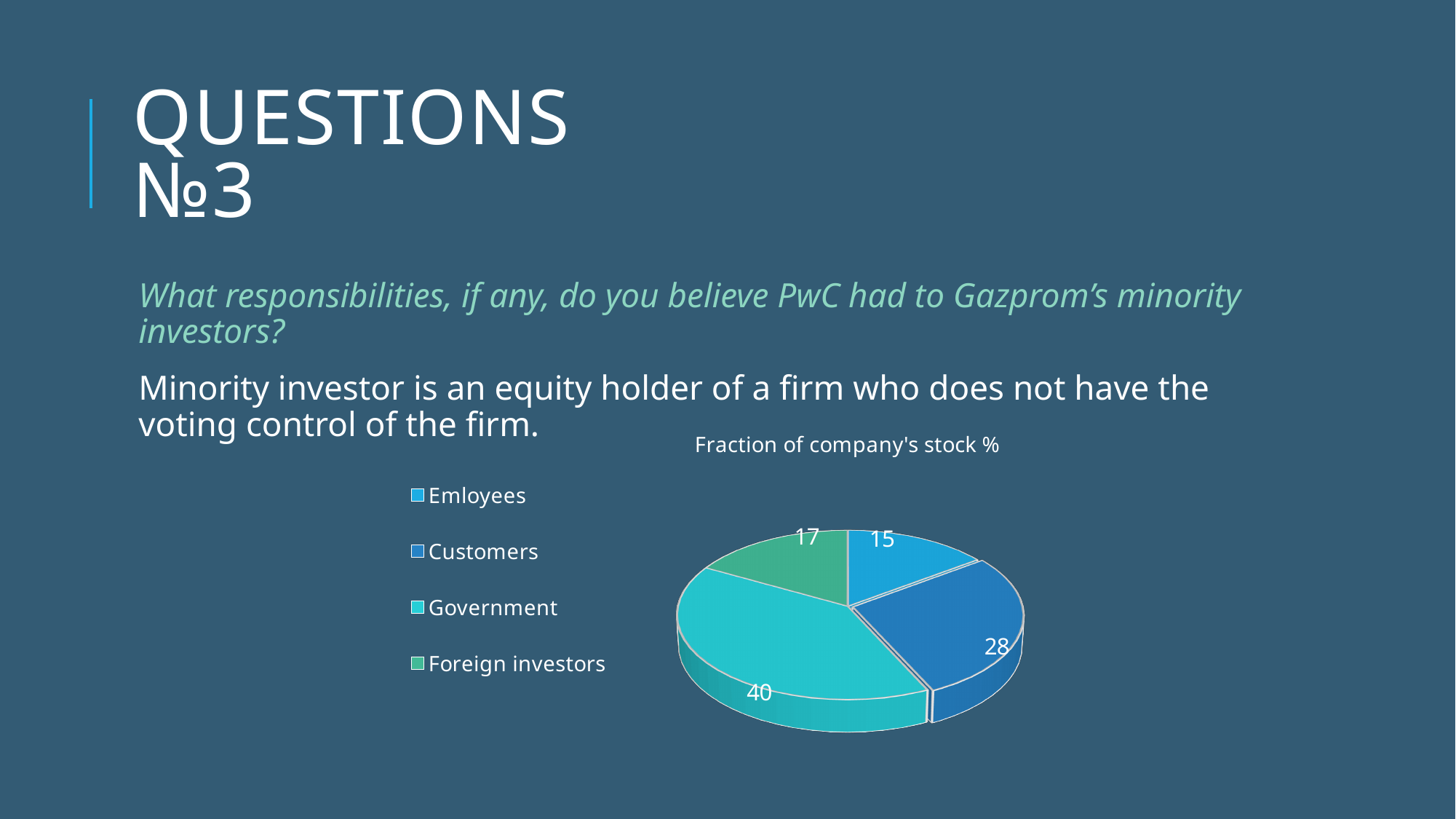
What is the value for Foreign investors in the pie chart? 17 What is the value for Emloyees in the pie chart? 15 How many slices does the pie chart have? 4 Which category has the largest slice of the pie chart? Government What is the difference between the Government and Customers values in the pie chart? 12 Which is larger in the pie chart, Foreign investors or Emloyees? Foreign investors What is the total of all the slice values in the pie chart? 100 What is the title of the chart? Fraction of company's stock % Which category has the smallest slice of the pie chart? Emloyees What kind of chart is shown on the slide? Pie chart What is the value for Customers in the pie chart? 28 What is the value for Government in the pie chart? 40